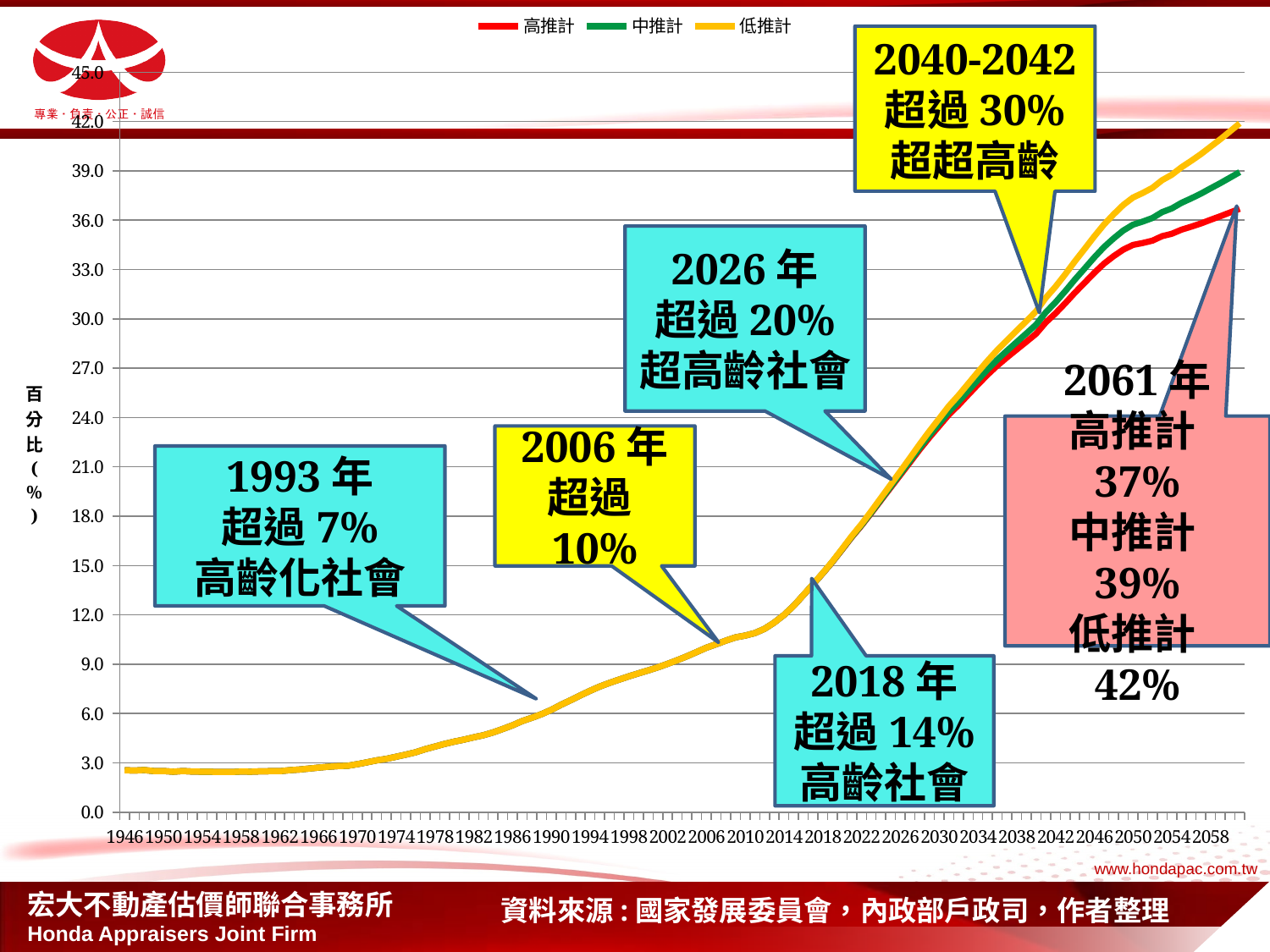
In 2058, which series is higher, 高推計 or 低推計? 低推計 What is the difference between the 低推計 and 高推計 values for 2061 shown in the callout? 5% Which projection has the highest value for 2061 according to the callout? 低推計 According to the callout, what is the 低推計 value for 2061? 42% According to the callout, what is the 中推計 value for 2061? 39% What are the three series named in the legend? 高推計, 中推計, 低推計 According to the callout, what is the 高推計 value for 2061? 37% What kind of chart is shown on the slide? line chart Do the plotted values rise or fall from 1946 to 2058? rise Which colour is used for the 低推計 series? yellow How many series does the legend list? 3 Is the value for 低推計 in 2058 greater or less than 39.0? greater